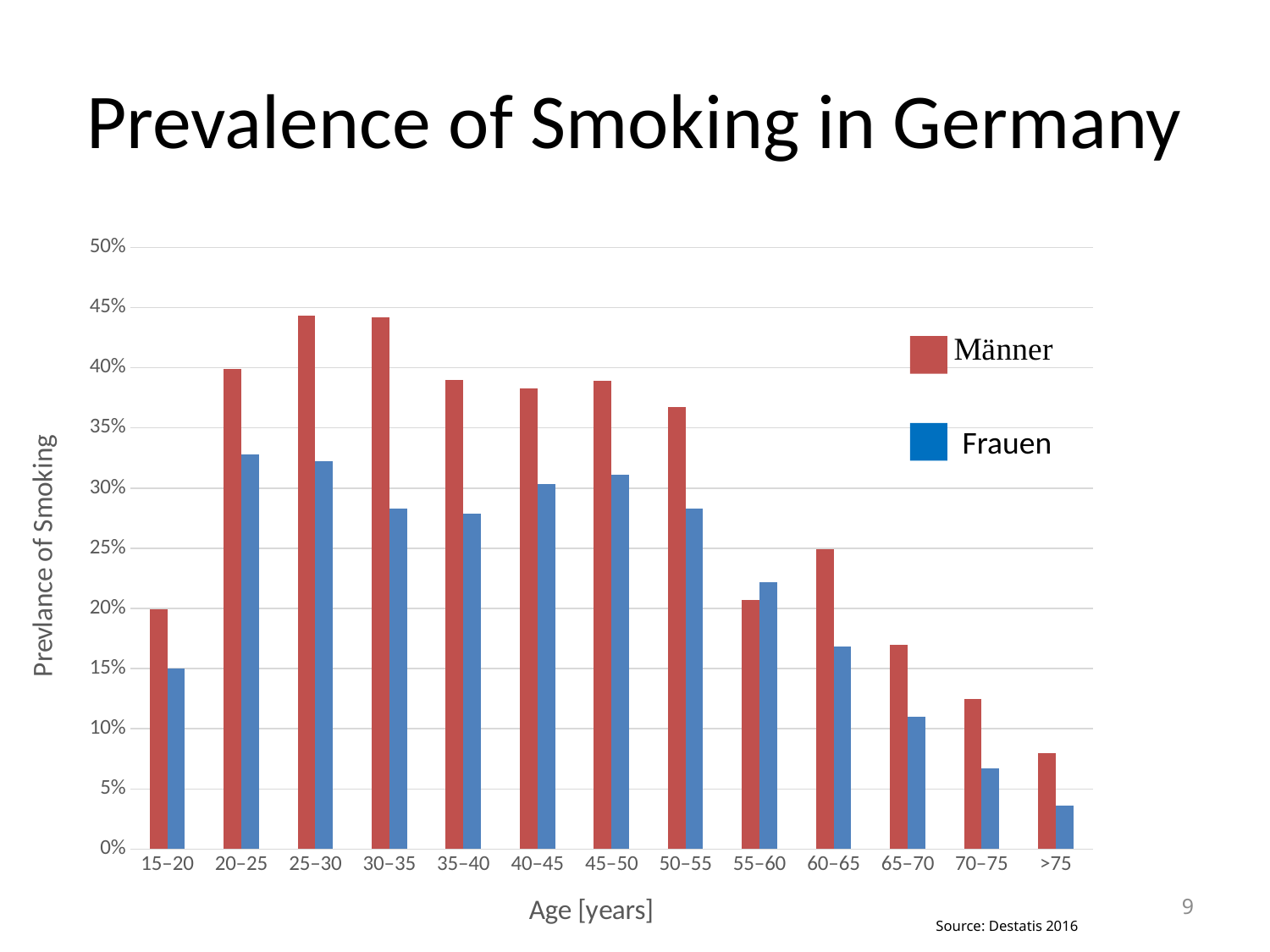
Do the Männer values rise or fall from the 50–55 age group to the >75 age group? fall In the 20–25 age group, which series has the larger value, Männer or Frauen? Männer How many series does the legend list? 2 Is the value for Frauen in the 60–65 age group greater or less than 20%? less Which age group has the lowest value for Frauen? >75 Which age group has the lowest value for Männer? >75 How many age categories are shown on the x axis? 13 Is the value for Frauen in the >75 age group greater or less than 5%? less What are the two entries in the legend? Männer and Frauen What kind of chart is shown on the slide? bar chart Is the value for Männer in the 25–30 age group greater or less than 40%? greater In the 55–60 age group, which series has the larger value, Männer or Frauen? Frauen